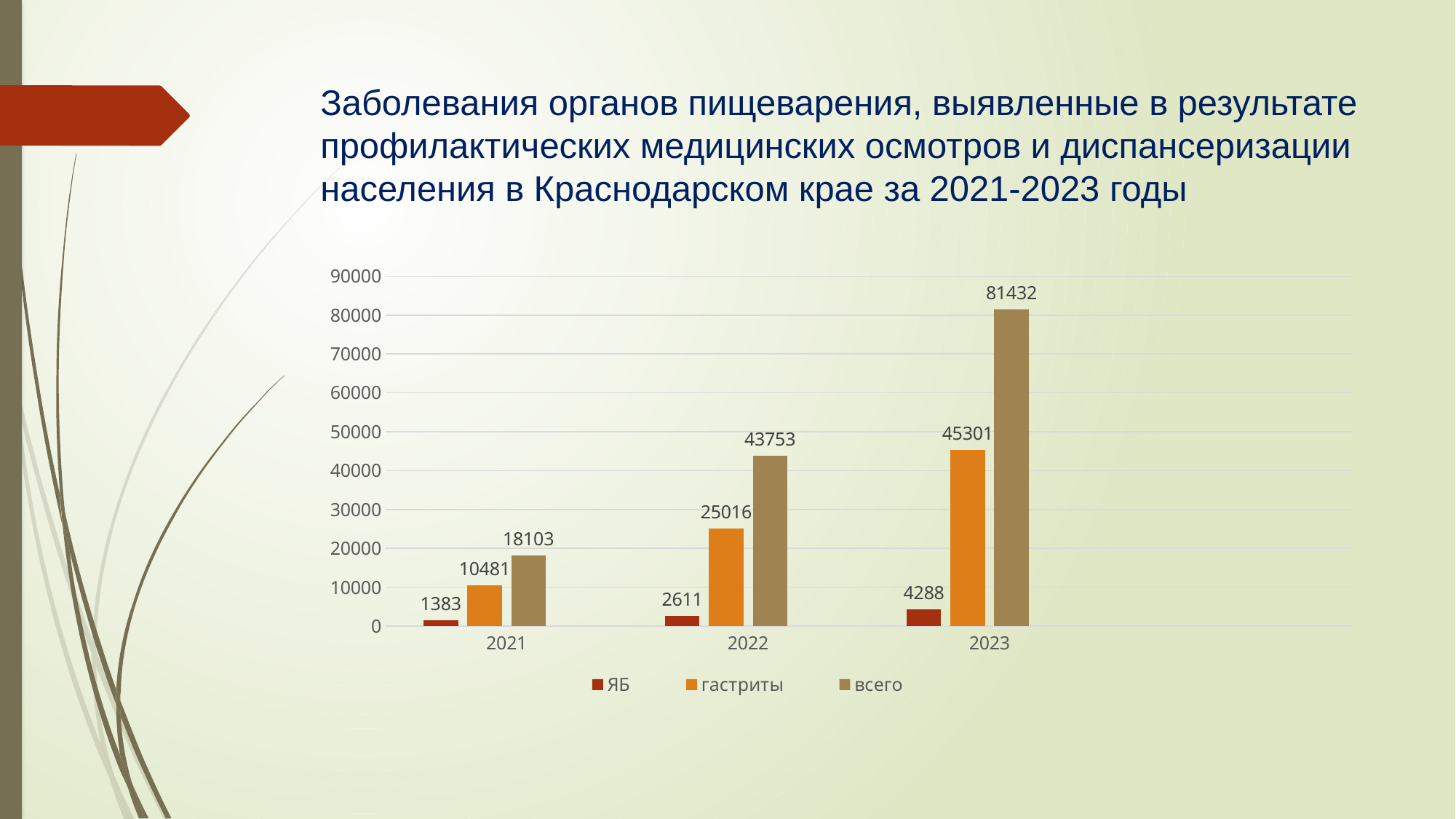
How many series does the legend list? 3 What is the value for "всего" in 2023? 81432 Do the values for "всего" rise or fall from 2021 to 2023? rise Which is larger: "гастриты" in 2023 or "всего" in 2022? гастриты in 2023 What is the value for "ЯБ" in 2021? 1383 How many years are shown on the x axis? 3 What is the difference between the "гастриты" values for 2022 and 2021? 14535 In which year is the value for "ЯБ" lowest? 2021 What is the difference between the "всего" values for 2023 and 2022? 37679 What kind of chart is shown on the slide? bar chart In which year is the value for "всего" highest? 2023 What is the value for "гастриты" in 2022? 25016